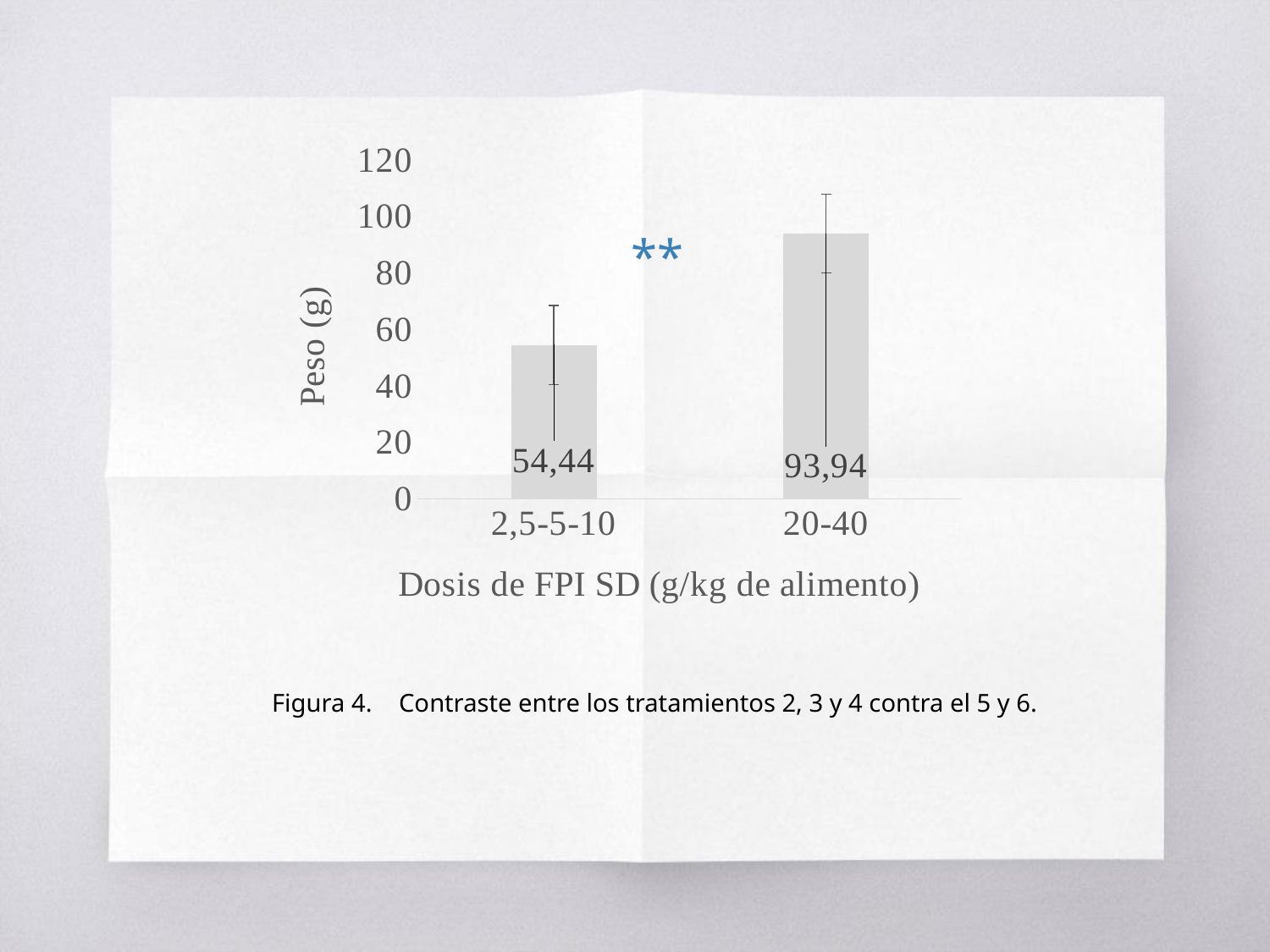
Which dose has the highest weight? 20-40 Which is larger, the value for 2,5-5-10 or the value for 20-40? 20-40 How many dose categories are shown on the x axis? 2 What is the difference between the values for 20-40 and 2,5-5-10? 39,50 What is the value for the 20-40 dose? 93,94 What is the label of the x axis? Dosis de FPI SD (g/kg de alimento) What kind of chart is shown on the slide? Bar chart What is the value for the 2,5-5-10 dose? 54,44 Is the value for 20-40 greater or less than 80? greater Which dose has the lowest weight? 2,5-5-10 What is the label of the y axis? Peso (g) Is the value for 2,5-5-10 greater or less than 60? less